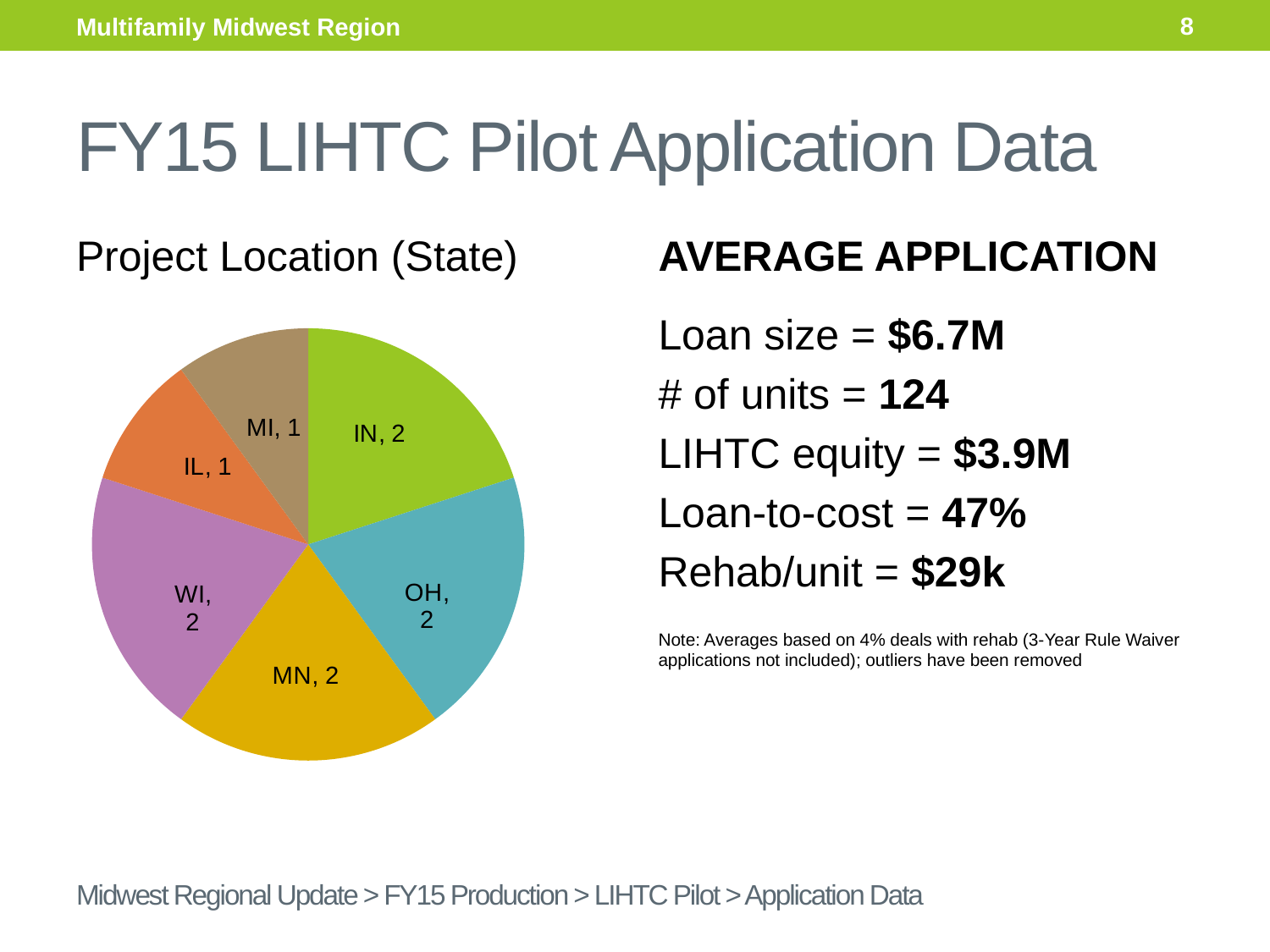
What is the total of all the slice values in the pie chart? 10 How many states (slices) are shown in the pie chart? 6 What is the value shown for WI in the pie chart? 2 What share of the pie does the IN slice represent? 20% What kind of chart is used to show Project Location (State)? Pie chart What is the value shown for IN in the pie chart? 2 What is the title of the pie chart? Project Location (State) Which is larger in the pie chart, the value for OH or the value for MI? OH What is the difference between the value for IN and the value for IL in the pie chart? 1 What is the value shown for MN in the pie chart? 2 What is the value shown for MI in the pie chart? 1 What is the value shown for IL in the pie chart? 1